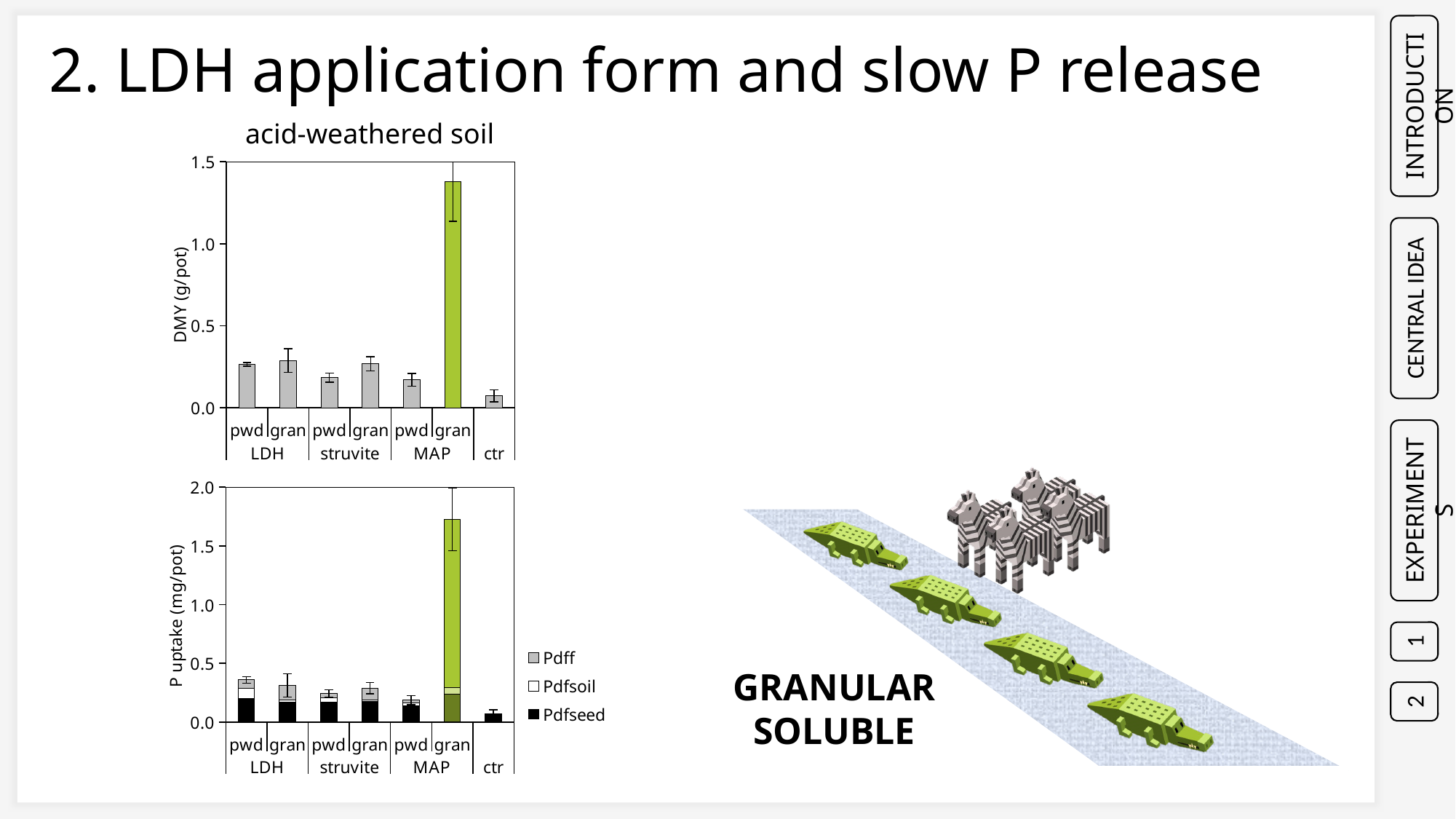
In the top chart (acid-weathered soil, DMY), which treatment has the highest dry matter yield? MAP gran In the bottom chart (P uptake mg/pot), which treatment has the lowest total P uptake? ctr In the top chart (DMY g/pot), which is larger: MAP gran or LDH gran? MAP gran In the bottom chart (P uptake mg/pot), which treatment has the highest total P uptake? MAP gran How many bars are plotted in the top chart (DMY g/pot)? 7 How many series does the legend of the bottom chart (P uptake) list? 3 In the top chart (DMY g/pot), is the value for LDH pwd greater or less than 0.5? less In the top chart (DMY g/pot), which treatment has the lowest value? ctr In the bottom chart (P uptake mg/pot), is the total for MAP gran greater or less than 1.5? greater In the top chart (DMY g/pot), is the value for MAP gran greater or less than 1.0? greater What are the three legend entries in the bottom chart (P uptake)? Pdff, Pdfsoil, Pdfseed What kind of chart is the top chart (DMY g/pot)? bar chart